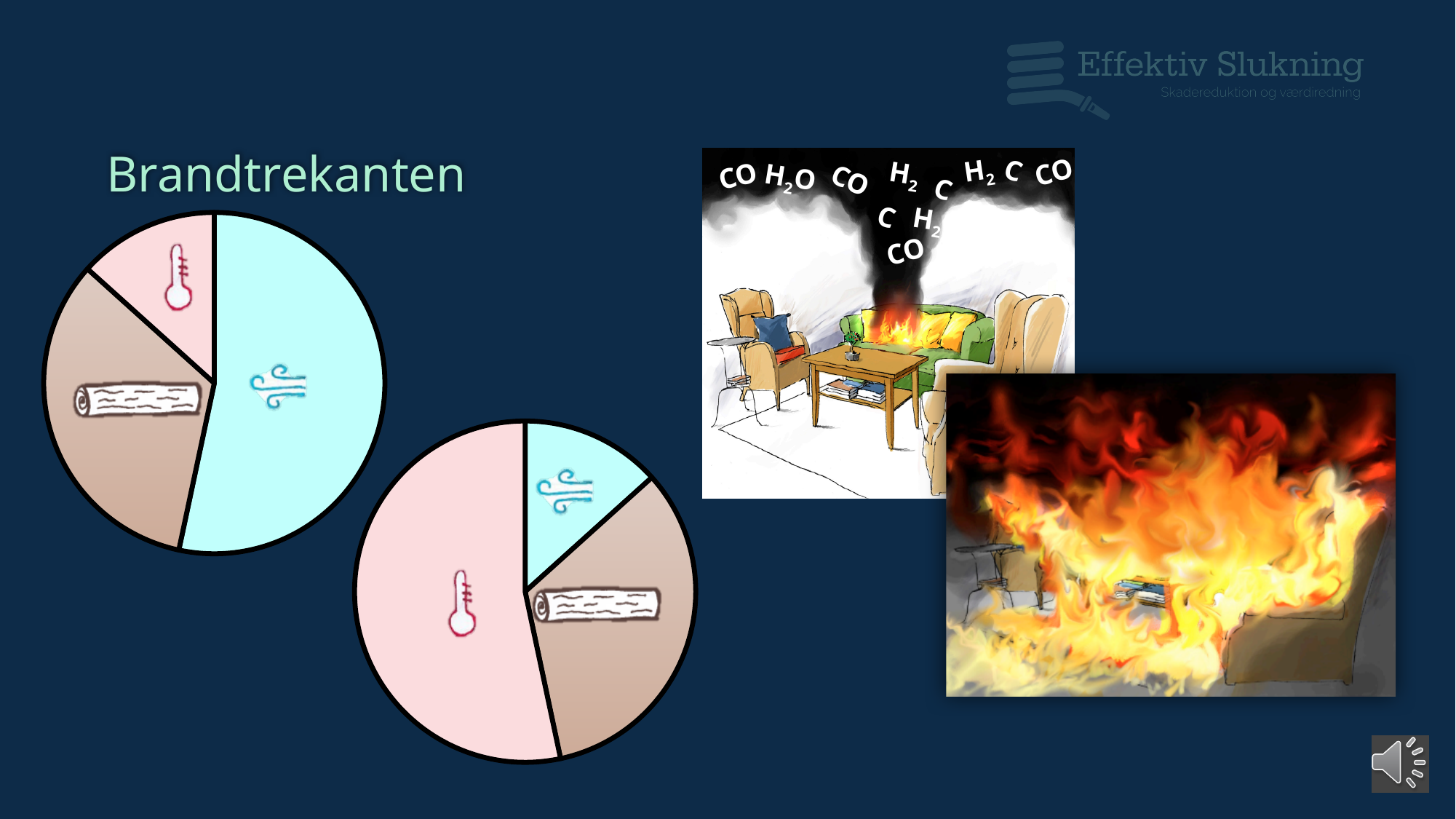
In the lower pie chart, which is larger: the slice with the wind icon or the slice with the log icon? the slice with the log icon In the lower pie chart, which slice is the smallest? the light blue slice with the wind icon What is the title shown above the pie charts on the slide? Brandtrekanten In the upper-left pie chart, which slice is the smallest? the pink slice with the thermometer icon How many slices does the upper-left pie chart have? 3 In the upper-left pie chart, which is larger: the slice with the log icon or the slice with the thermometer icon? the slice with the log icon In the lower pie chart, which slice is the largest? the pink slice with the thermometer icon What kind of chart is the lower chart on the slide? pie chart What kind of chart is the upper-left chart on the slide? pie chart How many pie charts are shown on the slide? 2 How many slices does the lower pie chart have? 3 In the upper-left pie chart, which slice is the largest? the light blue slice with the wind icon